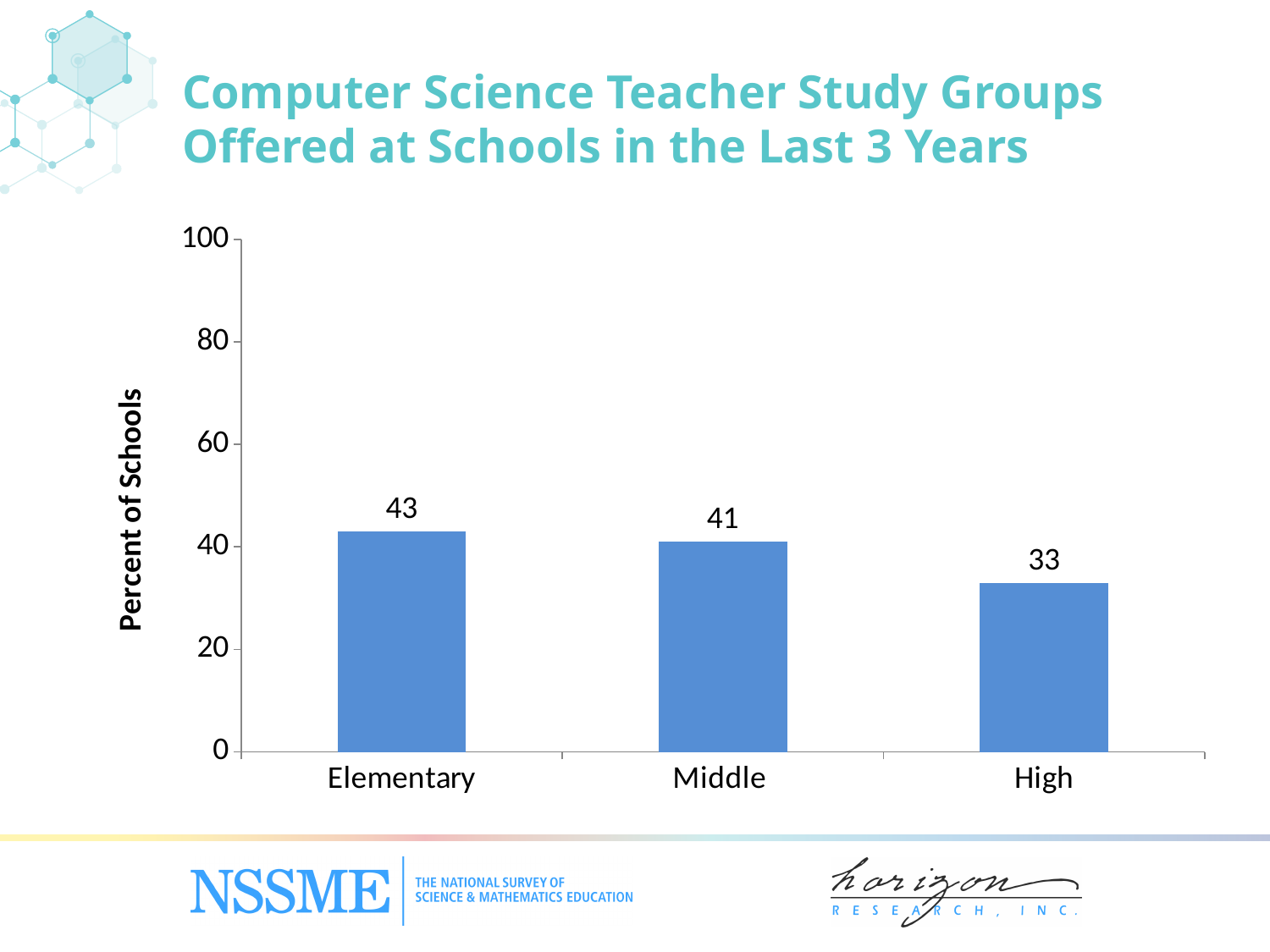
What is the value for Middle schools? 41 Is the value for High schools greater or less than 40? less How many school levels are shown on the chart? 3 What is the value for High schools? 33 What is the difference between the values for Elementary and High schools? 10 What kind of chart is shown on the slide? bar chart Which is larger, the value for Middle or the value for High? Middle Which school level has the lowest percent of schools? High Which school level has the highest percent of schools offering computer science teacher study groups? Elementary What is the difference between the values for Middle and High schools? 8 What is the label of the vertical axis? Percent of Schools What percent of elementary schools offered computer science teacher study groups in the last 3 years? 43